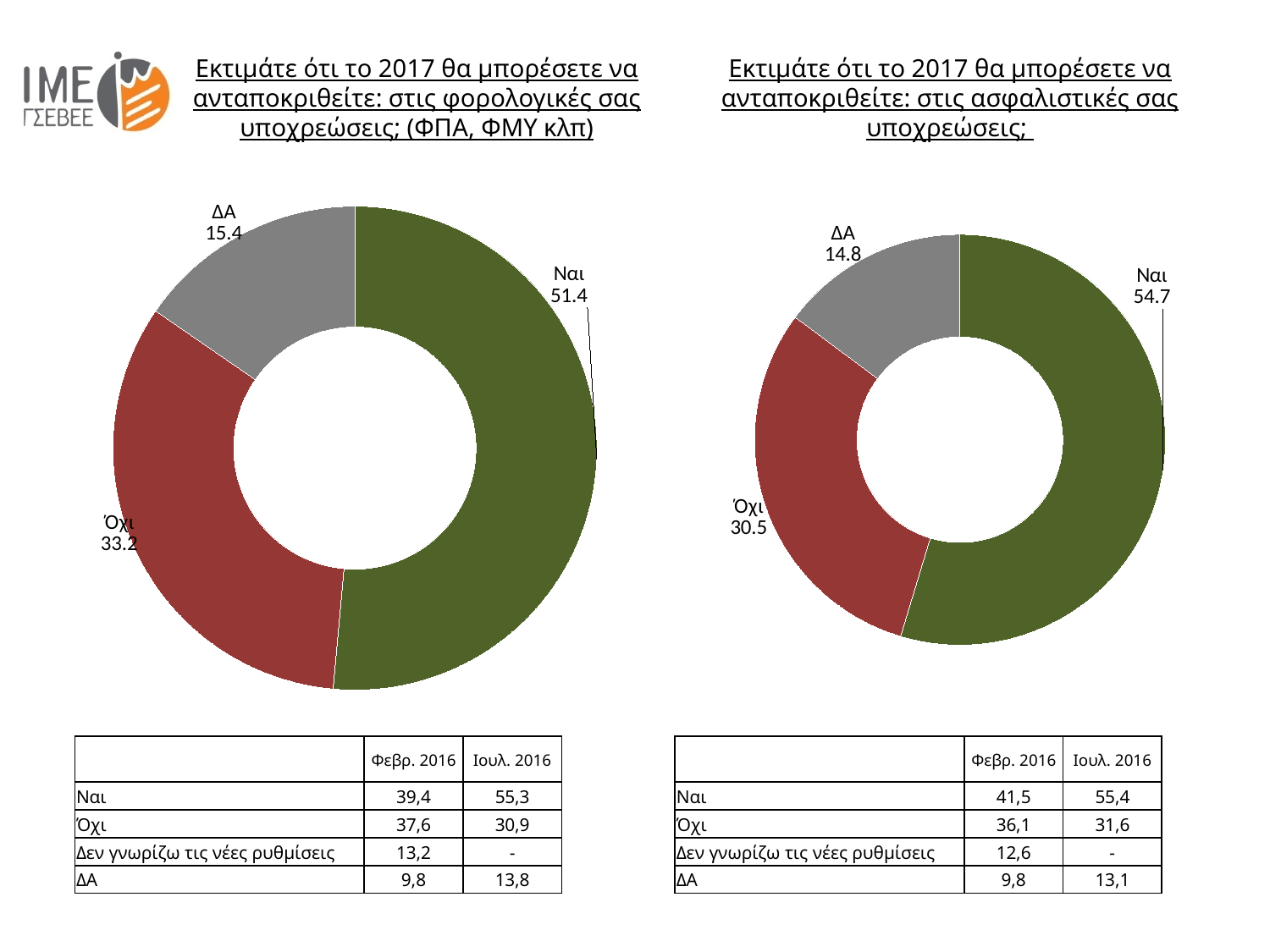
What type of chart is the left chart (φορολογικές υποχρεώσεις)? Doughnut (pie) chart In the left chart (φορολογικές υποχρεώσεις), what is the value for Ναι? 51.4 In the left chart (φορολογικές υποχρεώσεις), what is the value for Όχι? 33.2 In the right chart (ασφαλιστικές υποχρεώσεις), what is the value for Όχι? 30.5 In the right chart (ασφαλιστικές υποχρεώσεις), what is the value for ΔΑ? 14.8 In the right chart (ασφαλιστικές υποχρεώσεις), what is the value for Ναι? 54.7 In the left chart (φορολογικές υποχρεώσεις), which category has the largest share? Ναι In the left chart (φορολογικές υποχρεώσεις), what is the value for ΔΑ? 15.4 In the left chart (φορολογικές υποχρεώσεις), what is the difference between the values for Ναι and Όχι? 18.2 How many categories does the right chart (ασφαλιστικές υποχρεώσεις) show? 3 In the right chart (ασφαλιστικές υποχρεώσεις), which category has the smallest share? ΔΑ Is the value for Ναι larger in the left chart (φορολογικές) or in the right chart (ασφαλιστικές)? Right chart (ασφαλιστικές)